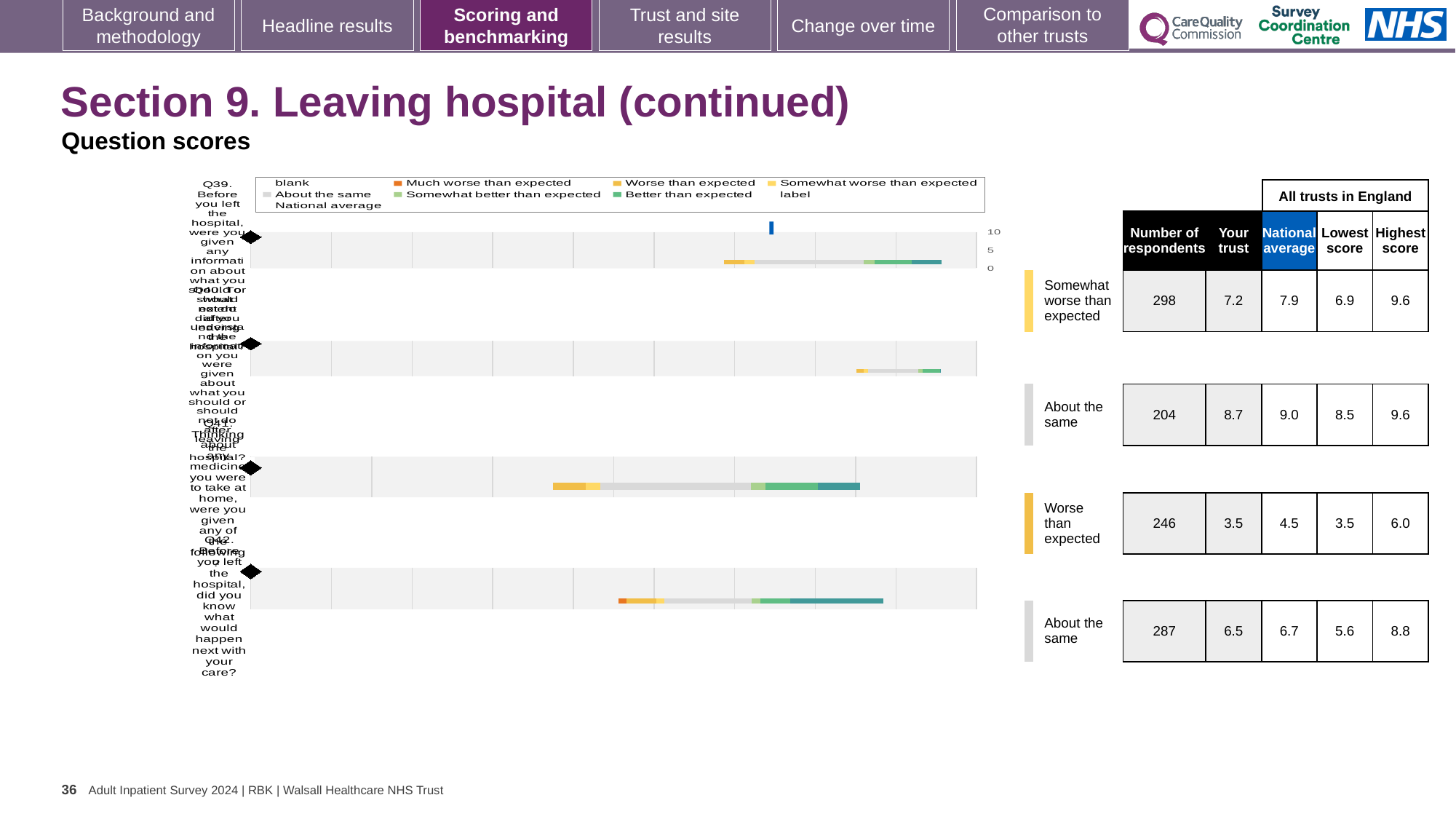
What colour does the legend use for 'Much worse than expected'? orange How many question rows (bars) are plotted in the chart? 4 In the table beside the chart, what is the 'Your trust' score for the first row (Somewhat worse than expected)? 7.2 In the table beside the chart, which row has the lowest 'Your trust' score? Worse than expected (3.5) In the table beside the chart, is the 'Your trust' score for the last row (6.5) larger or smaller than its National average (6.7)? smaller In the table beside the chart, what is the National average for the row labelled 'Worse than expected'? 4.5 In the table beside the chart, which row has the highest 'Your trust' score? About the same (8.7) How many entries does the chart's legend list? 9 What is the highest tick value shown on the chart's axis? 10 In the table beside the chart, what is the difference between the Highest score and Lowest score for the row labelled 'Worse than expected'? 2.5 In the table beside the chart, how many respondents are listed for the second row (About the same, score 8.7)? 204 What kind of chart is shown on the left of the slide? bar chart